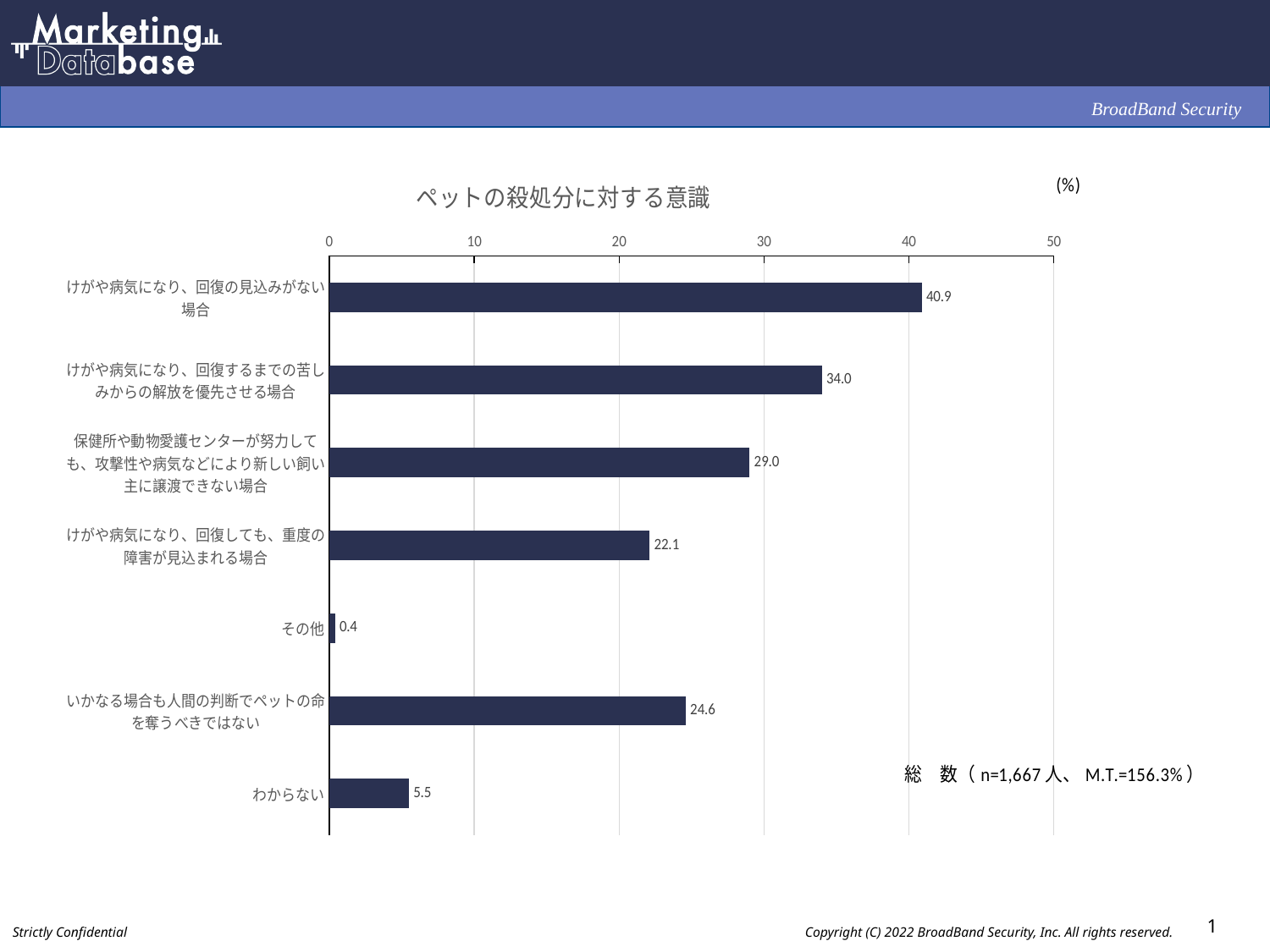
What is the title of the chart? ペットの殺処分に対する意識 What is the difference between 「けがや病気になり、回復するまでの苦しみからの解放を優先させる場合」 and 「保健所や動物愛護センターが努力しても、攻撃性や病気などにより新しい飼い主に譲渡できない場合」? 5.0 What is the value for 「けがや病気になり、回復の見込みがない場合」? 40.9 What is the value for 「わからない」? 5.5 How many categories are shown in the chart? 7 What is the sample size (n) shown on the slide? 1,667人 Is the value for 「けがや病気になり、回復するまでの苦しみからの解放を優先させる場合」 greater or less than 30? greater Which category has the highest value? けがや病気になり、回復の見込みがない場合 Which is larger: 「けがや病気になり、回復しても、重度の障害が見込まれる場合」 or 「いかなる場合も人間の判断でペットの命を奪うべきではない」? いかなる場合も人間の判断でペットの命を奪うべきではない What kind of chart is shown on the slide? bar chart What is the value for 「いかなる場合も人間の判断でペットの命を奪うべきではない」? 24.6 Which category has the lowest value? その他